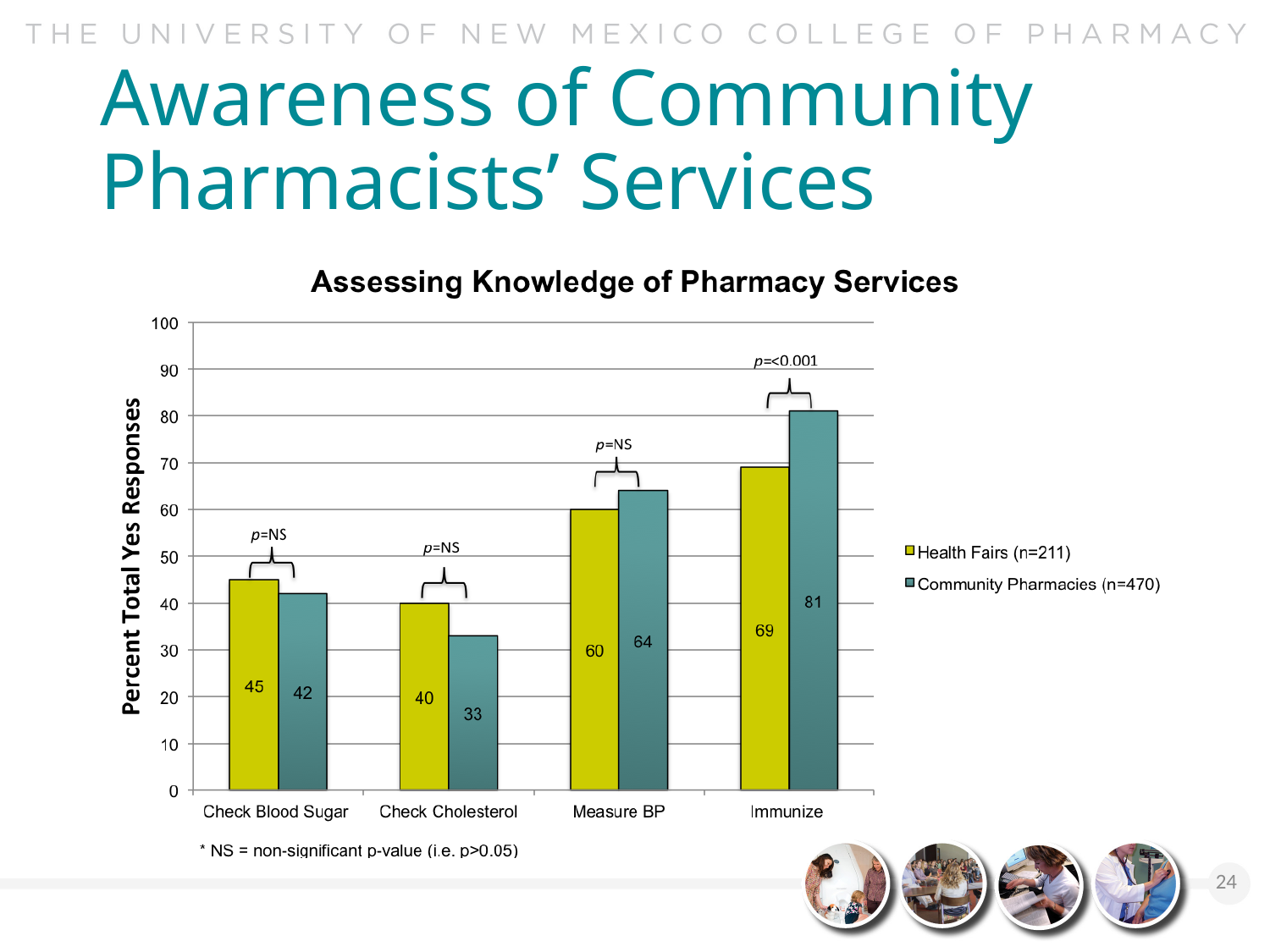
What is the value for Community Pharmacies for Check Cholesterol? 33 What is the value for Health Fairs for Check Blood Sugar? 45 For Check Cholesterol, which series has the larger value, Health Fairs or Community Pharmacies? Health Fairs What is the value for Community Pharmacies for Immunize? 81 What is the title of the chart? Assessing Knowledge of Pharmacy Services How many categories are shown on the x axis? 4 How many series does the legend list? 2 Which category has the highest value for Community Pharmacies? Immunize What kind of chart is shown? Bar chart Which category has the lowest value for Health Fairs? Check Cholesterol Is the Health Fairs value for Measure BP greater or less than 50? greater What is the difference between the Community Pharmacies and Health Fairs values for Immunize? 12